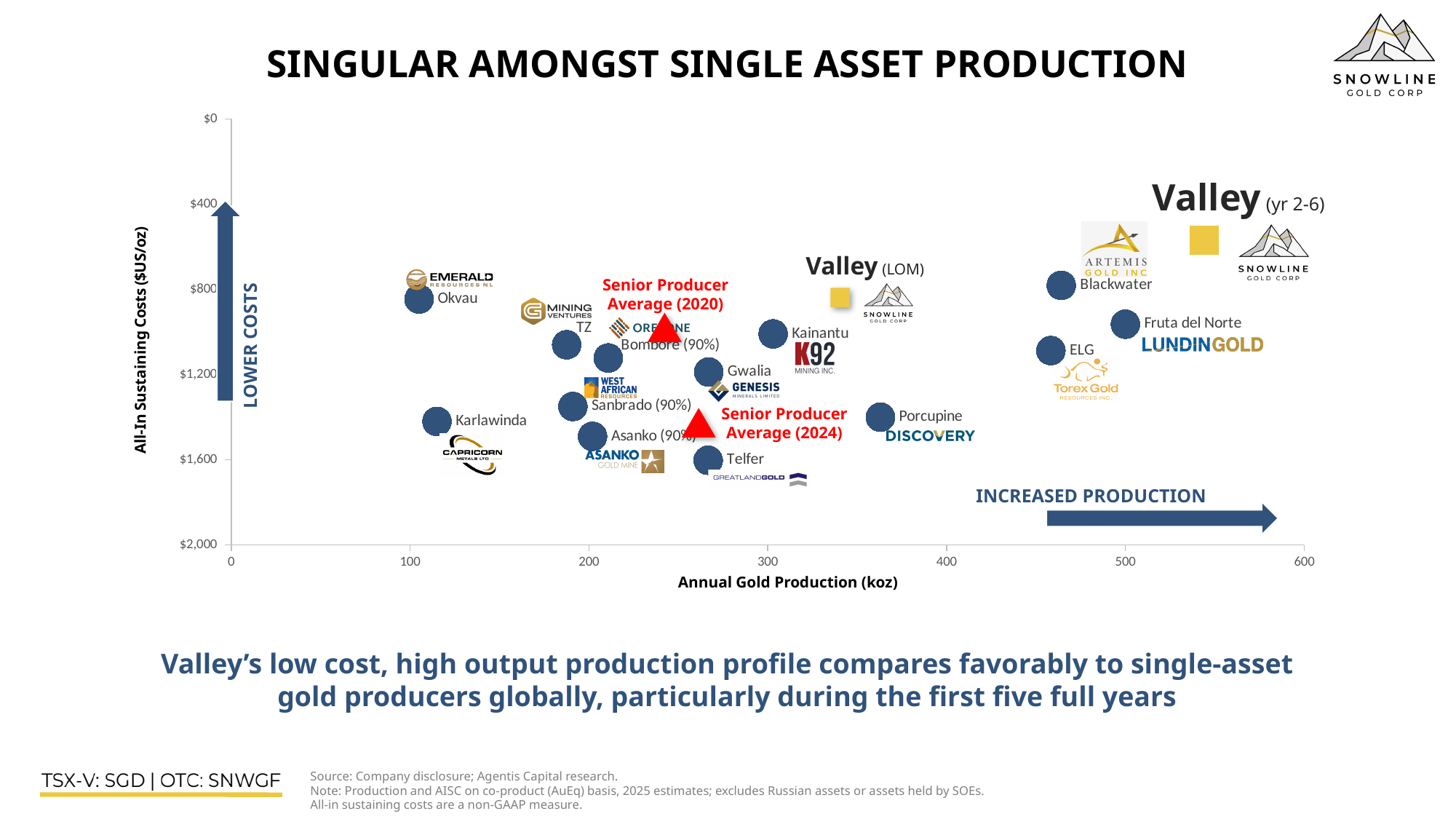
Which plotted asset has the lowest annual gold production? Okvau Which plotted asset has the highest annual gold production? Valley (yr 2-6) Which plotted asset has the highest all-in sustaining cost? Telfer What is the label of the x axis of the chart? Annual Gold Production (koz) Is the annual gold production for Okvau greater or less than 200 koz? less Is the annual gold production for Valley (yr 2-6) greater or less than 500 koz? greater Is the annual gold production for Porcupine greater or less than 400 koz? less What is the title of the chart on the slide? SINGULAR AMONGST SINGLE ASSET PRODUCTION What kind of chart is shown on the slide? Scatter chart Which has a higher all-in sustaining cost, the Senior Producer Average (2024) or the Senior Producer Average (2020)? Senior Producer Average (2024) Which has higher annual gold production, Porcupine or Gwalia? Porcupine